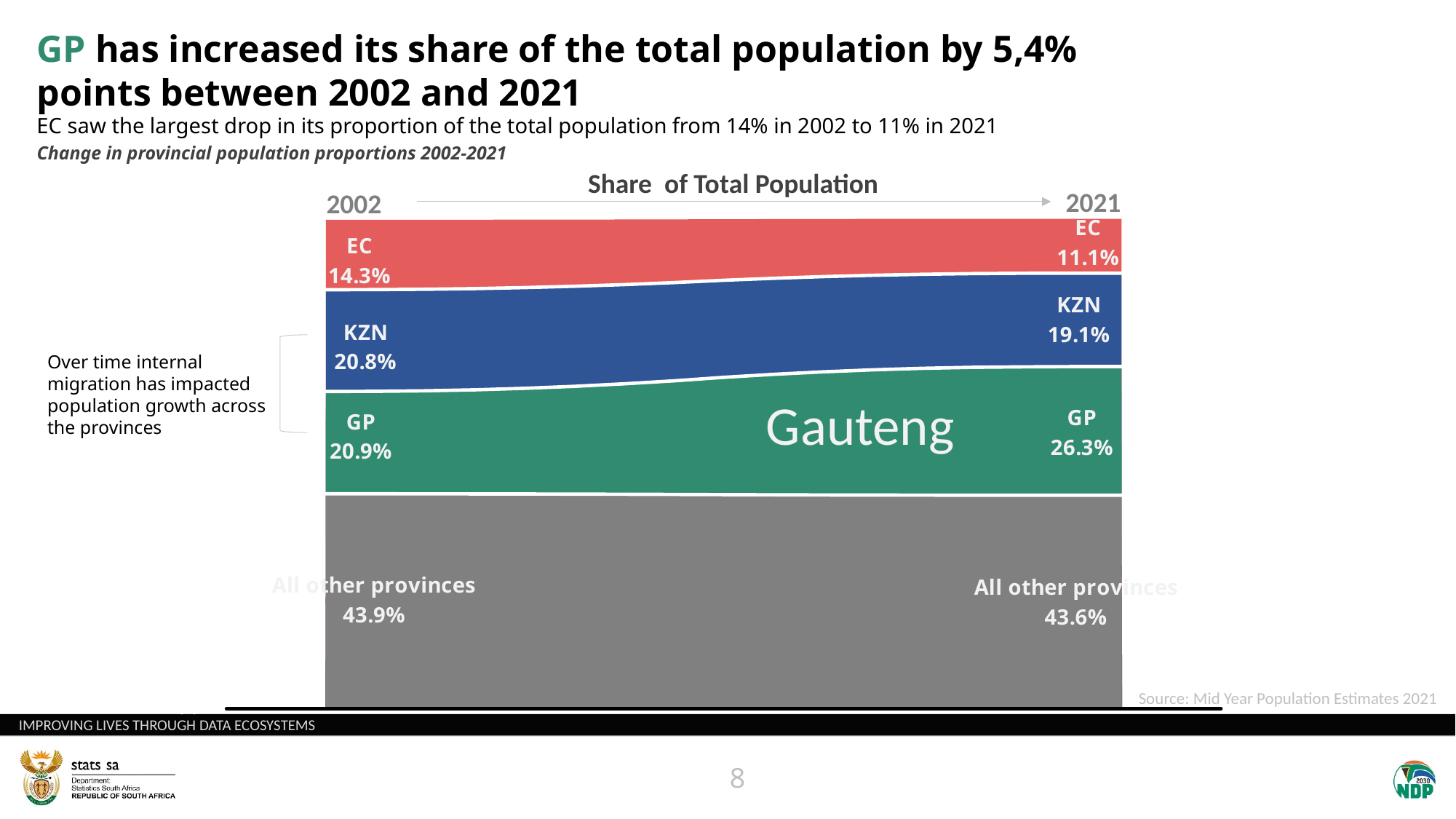
What share of the total population did KZN have in 2021? 19.1% What share of the total population did GP have in 2021? 26.3% What share of the total population did EC have in 2002? 14.3% What share of the total population did 'All other provinces' have in 2002? 43.9% Which province had the smallest share of the total population in 2021? EC Which was larger in 2021, the share for GP or the share for KZN? GP By how many percentage points did GP's share of the total population change between 2002 and 2021? 5.4 percentage points By how many percentage points did EC's share of the total population fall between 2002 and 2021? 3.2 percentage points Which province group had the largest share of the total population in 2021? All other provinces How many province groups are shown in the chart? 4 Did KZN's share of the total population rise or fall from 2002 to 2021? Fall What type of chart is used to show the share of total population? Stacked area chart